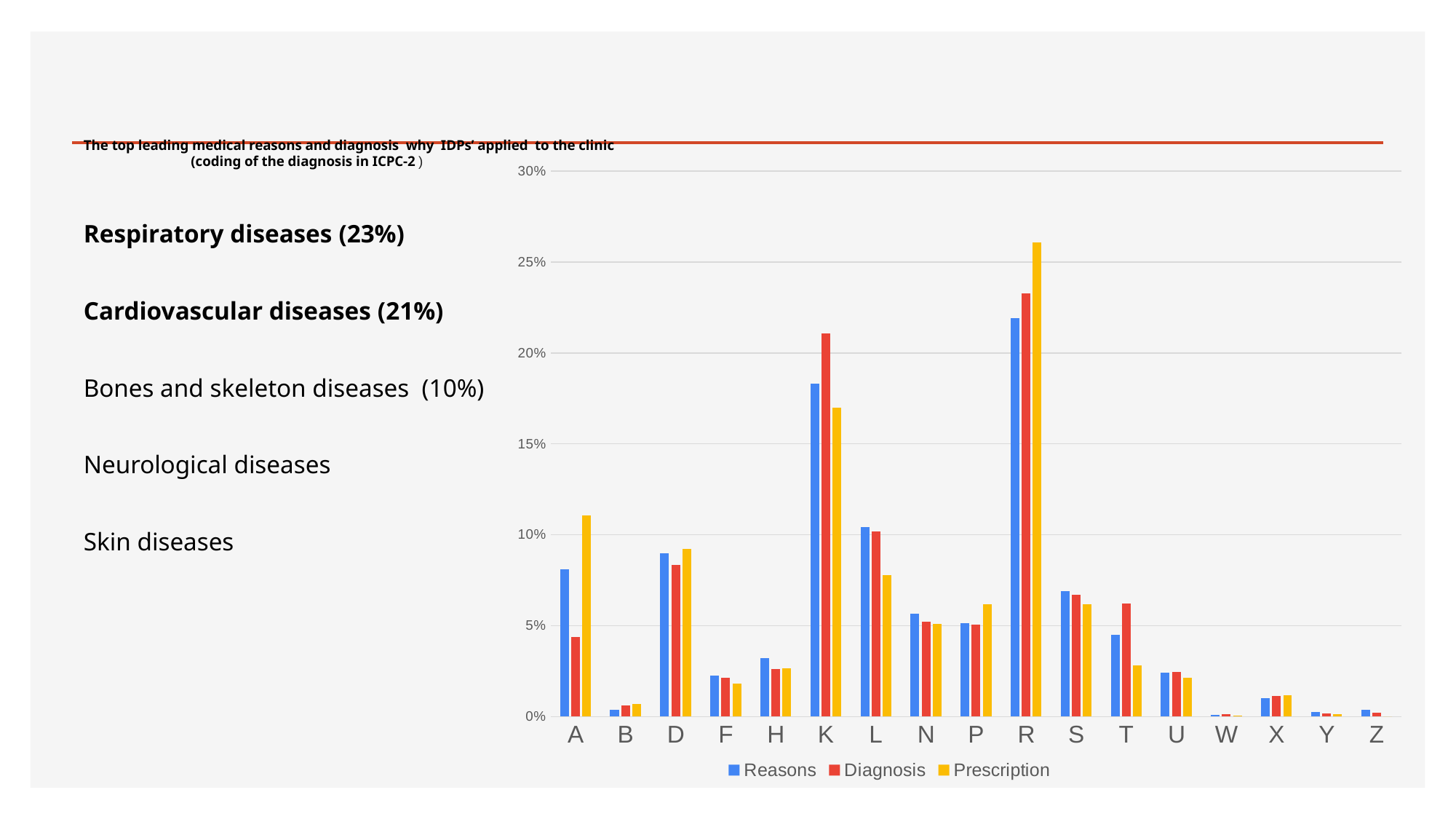
How many series does the chart legend list? 3 Is the Diagnosis value for K greater or less than 20%? greater Is the Reasons value for K greater or less than 20%? less Which colour represents the Prescription series in the chart? Yellow How many categories are shown along the x axis of the chart? 17 Which category has the highest Prescription value? R What kind of chart is shown on the slide? Bar chart Is the Prescription value for R greater or less than 25%? greater Which category has the highest Reasons value? R For category K, which is larger: the Reasons value or the Diagnosis value? Diagnosis